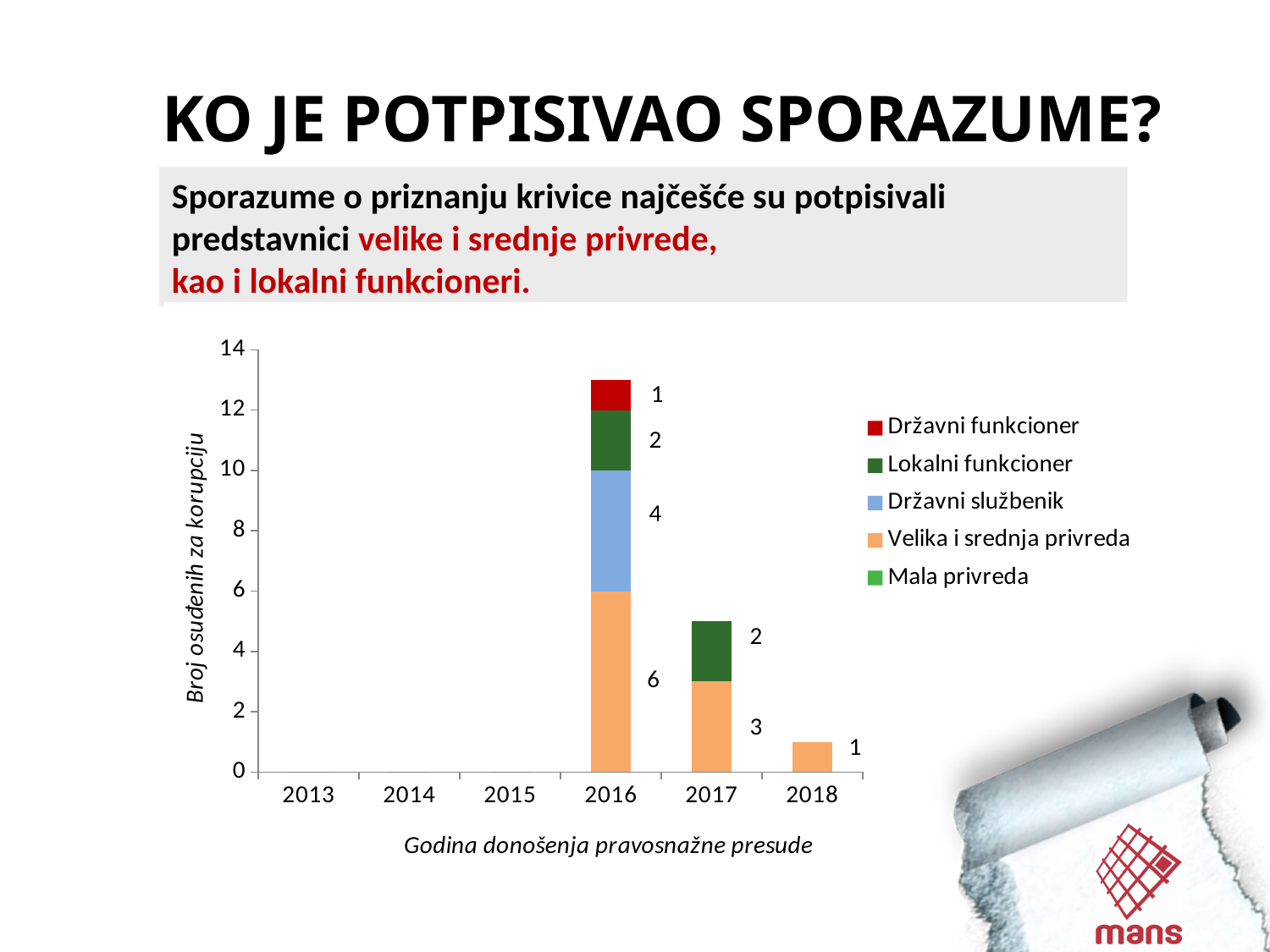
What kind of chart is shown on the slide? stacked bar chart What is the difference between the Velika i srednja privreda values for 2016 and 2017? 3 What is the value for Velika i srednja privreda in 2016? 6 What is the value for Lokalni funkcioner in 2017? 2 What is the total of the stacked bar for 2017? 5 How many series does the legend list? 5 How many years are shown on the x axis? 6 What is the total of the stacked bar for 2016? 13 What is the value for Velika i srednja privreda in 2018? 1 Which series is shown in red in the legend? Državni funkcioner Which year has the highest total number of convicted persons? 2016 What is the value for Državni službenik in 2016? 4